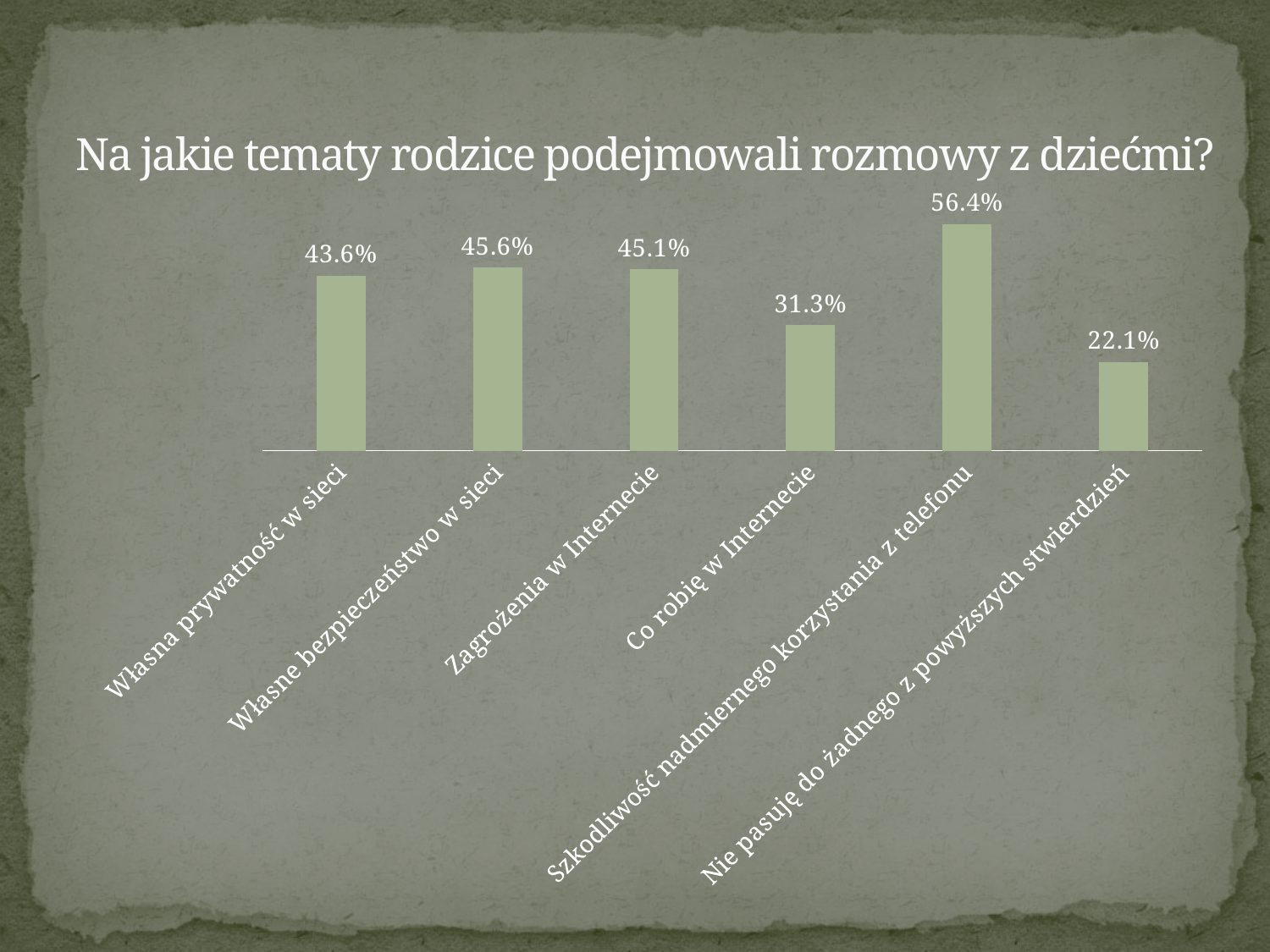
What is the value for "Co robię w Internecie"? 31.3% What is the title of the chart? Na jakie tematy rodzice podejmowali rozmowy z dziećmi? What is the value for "Nie pasuję do żadnego z powyższych stwierdzień"? 22.1% What is the difference between the values for "Własne bezpieczeństwo w sieci" and "Własna prywatność w sieci"? 2.0% What is the difference between the values for "Szkodliwość nadmiernego korzystania z telefonu" and "Nie pasuję do żadnego z powyższych stwierdzień"? 34.3% Which category has the highest value? Szkodliwość nadmiernego korzystania z telefonu What kind of chart is shown on the slide? Bar chart What is the value for "Szkodliwość nadmiernego korzystania z telefonu"? 56.4% What is the value for "Własna prywatność w sieci"? 43.6% Which category has the lowest value? Nie pasuję do żadnego z powyższych stwierdzień How many categories are shown in the chart? 6 Which is larger, the value for "Własna prywatność w sieci" or the value for "Co robię w Internecie"? Własna prywatność w sieci